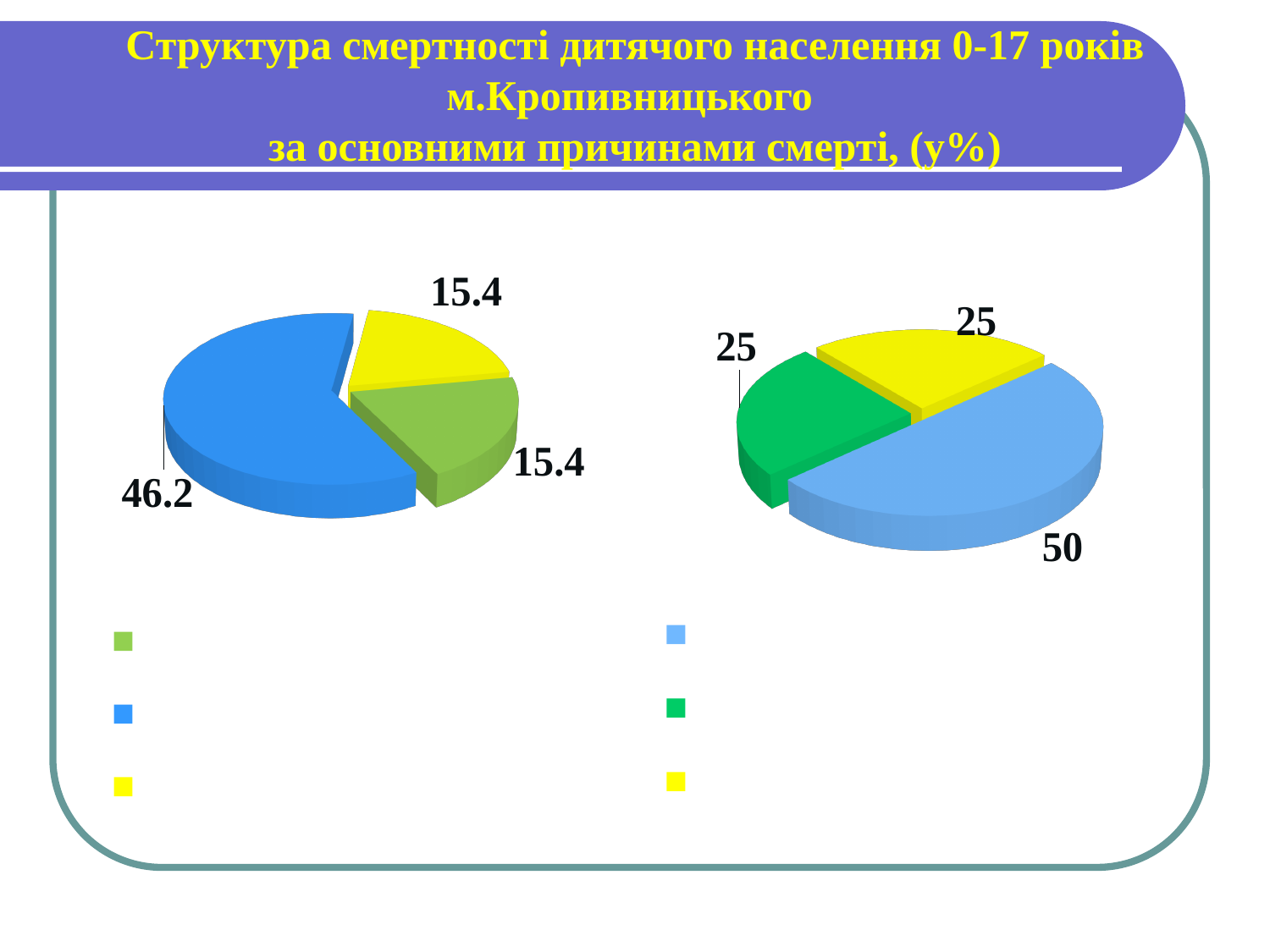
In the right pie chart, what is the difference between the light blue slice and the yellow slice? 25 In the left pie chart, which colour slice has the largest value? blue What kind of chart is the chart on the left of the slide? pie chart In the right pie chart, what value is shown for the green slice? 25 In the left pie chart, what value is shown for the yellow slice? 15.4 What kind of chart is the chart on the right of the slide? pie chart In the right pie chart, what value is shown for the light blue slice? 50 In the left pie chart, what is the difference between the blue slice and the yellow slice? 30.8 In the left pie chart, what value is shown for the blue slice? 46.2 How many slices does the right pie chart have? 3 How many slices does the left pie chart have? 3 In the right pie chart, which colour slice has the largest value? light blue